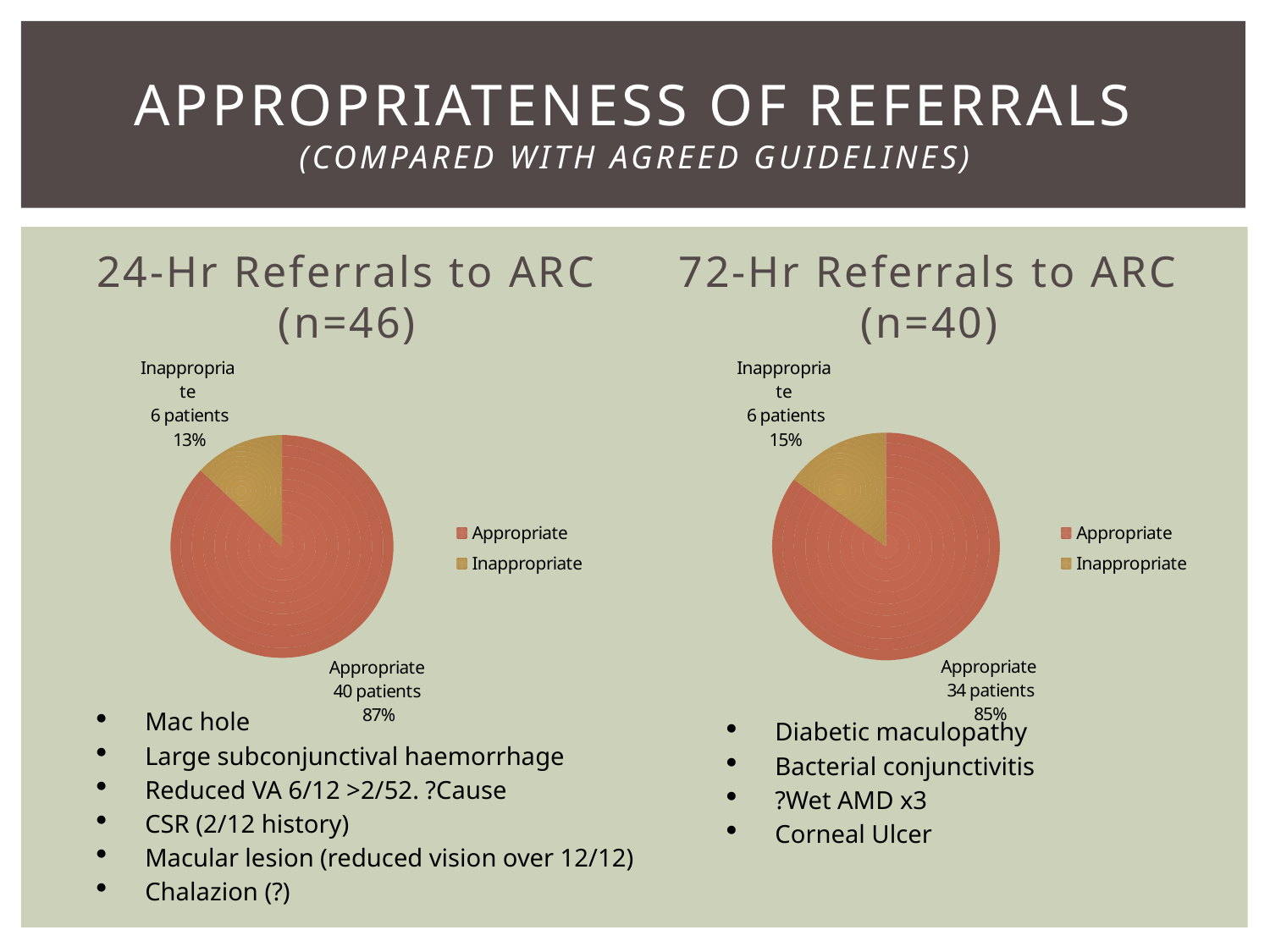
In the 24-Hr Referrals to ARC chart, what percentage of referrals were Appropriate? 87% In the 72-Hr Referrals to ARC chart, what is the difference in percentage points between Appropriate and Inappropriate? 70 Which chart has the larger Appropriate share, the 24-Hr Referrals to ARC chart or the 72-Hr Referrals to ARC chart? 24-Hr Referrals to ARC How many categories does the legend of the 24-Hr Referrals to ARC chart list? 2 What type of chart is the 72-Hr Referrals to ARC chart? Pie chart In the 72-Hr Referrals to ARC chart, which category has the smallest slice? Inappropriate In the 72-Hr Referrals to ARC chart, what colour is the Inappropriate slice? Gold In the 72-Hr Referrals to ARC chart, what percentage of referrals were Inappropriate? 15% In the 72-Hr Referrals to ARC chart, how many patients were Appropriate? 34 patients In the 24-Hr Referrals to ARC chart, what is the difference in patients between Appropriate and Inappropriate? 34 patients In the 24-Hr Referrals to ARC chart, which category has the largest slice? Appropriate In the 24-Hr Referrals to ARC chart, how many patients were Inappropriate? 6 patients